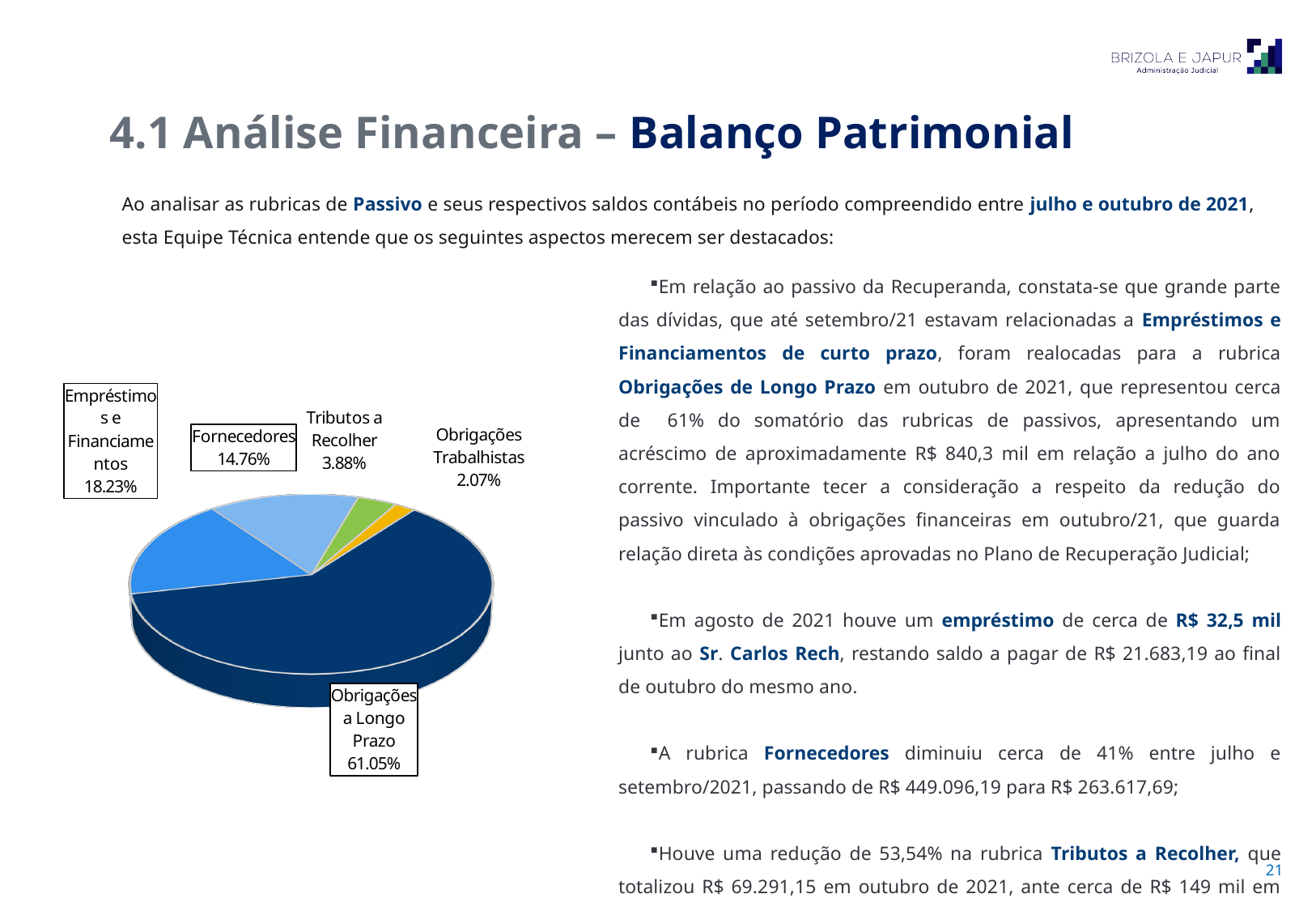
What kind of chart is shown on the slide? Pie chart Which category has the largest slice of the pie? Obrigações a Longo Prazo How many slices does the pie chart have? 5 What colour is the slice for Obrigações a Longo Prazo? Dark blue What percentage is shown for Empréstimos e Financiamentos? 18.23% What share of the pie does Obrigações a Longo Prazo represent? 61.05% Which category has the smallest slice of the pie? Obrigações Trabalhistas What is the difference in percentage points between Empréstimos e Financiamentos and Fornecedores? 3.47 What percentage is shown for Fornecedores? 14.76% What percentage is shown for Obrigações Trabalhistas? 2.07% Which is larger, the slice for Tributos a Recolher or the slice for Obrigações Trabalhistas? Tributos a Recolher What percentage is shown for Tributos a Recolher? 3.88%